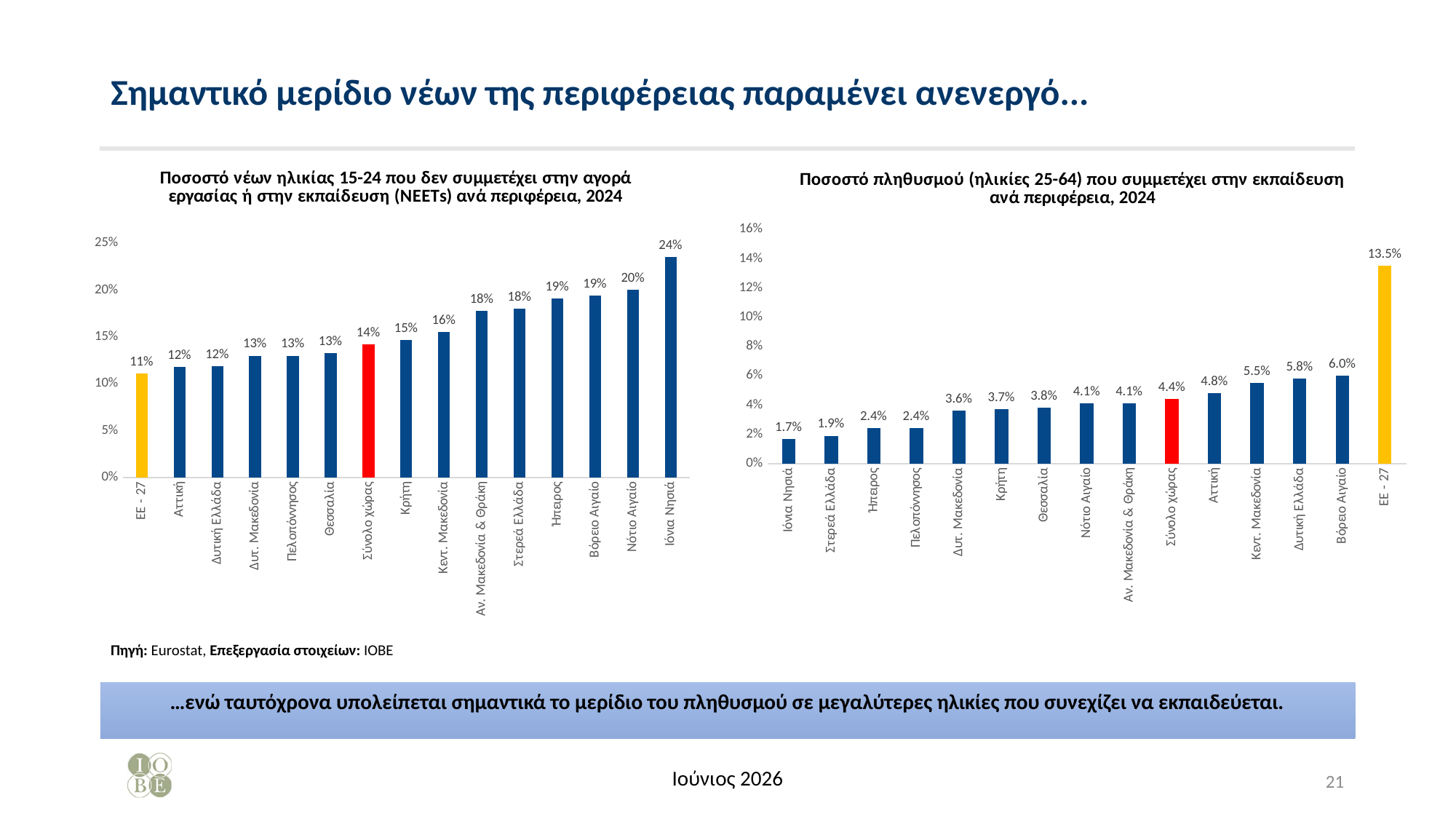
In the right chart (population aged 25-64 in education, 2024), what is the value for ΕΕ - 27? 13.5% In the right chart (population aged 25-64 in education, 2024), which region has the lowest value? Ιόνια Νησιά In the left chart (NEETs by region, 2024), what is the value for Σύνολο χώρας? 14% In the right chart (population aged 25-64 in education, 2024), what is the difference between ΕΕ - 27 and Σύνολο χώρας? 9.1 percentage points In the left chart (NEETs by region, 2024), what is the difference between Ιόνια Νησιά and ΕΕ - 27? 13 percentage points In the right chart (population aged 25-64 in education, 2024), which is larger: Αττική or Κρήτη? Αττική In the left chart (NEETs by region, 2024), which region has the highest value? Ιόνια Νησιά In the right chart (population aged 25-64 in education, 2024), what colour is the bar for Σύνολο χώρας? red What type of chart is the right chart (population aged 25-64 in education, 2024)? bar chart In the left chart (NEETs by region, 2024), what is the value for Ιόνια Νησιά? 24% In the left chart (NEETs by region, 2024), do the values rise or fall from left to right? rise In the left chart (NEETs by region, 2024), how many bars are plotted? 15